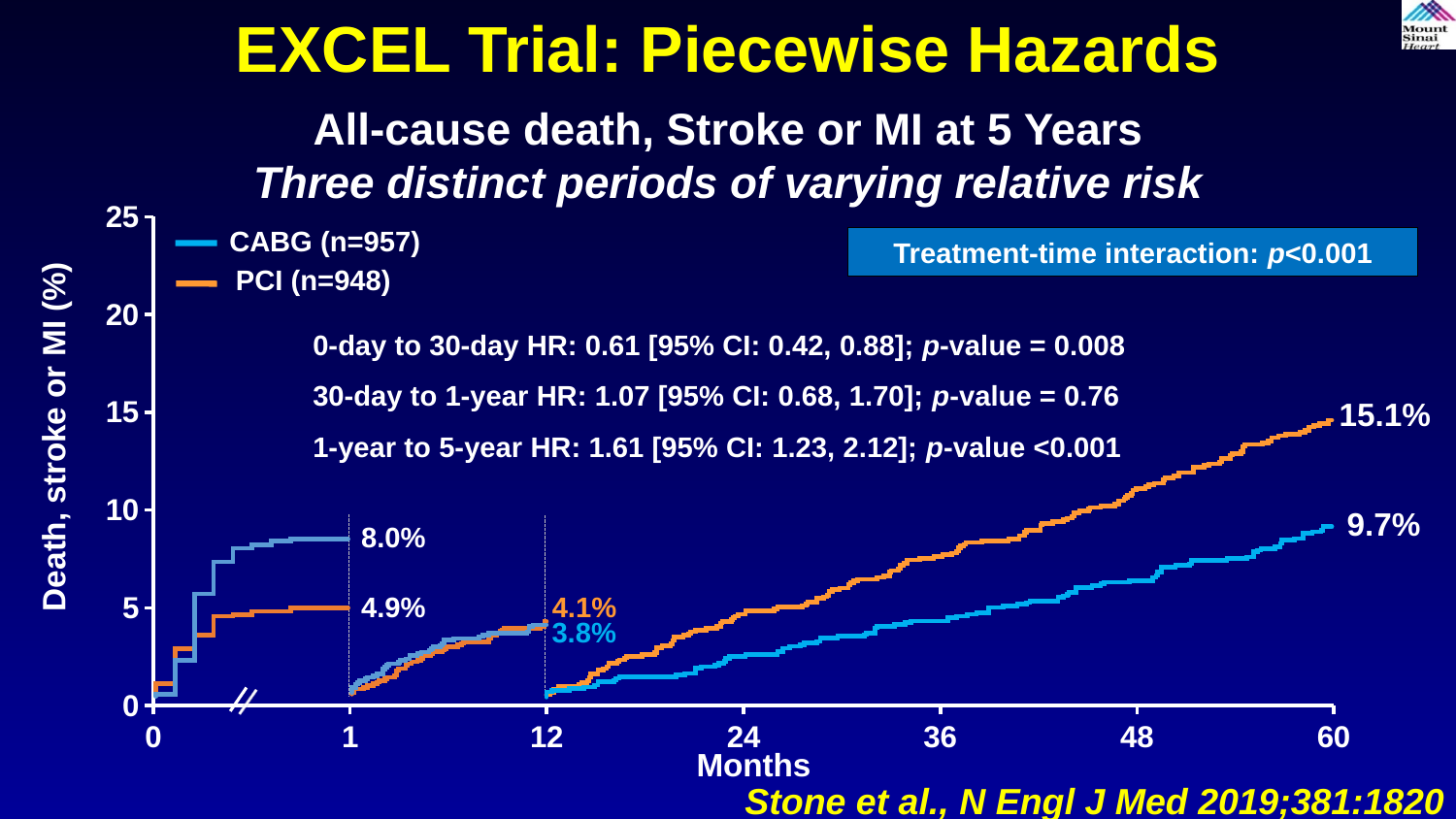
What is the label of the y axis? Death, stroke or MI (%) Which series has the higher value at 1 month, CABG or PCI? CABG What is the value for PCI at 1 month? 4.9% What is the value for CABG at 1 month? 8.0% What is the difference between the PCI and CABG values at 60 months? 5.4% How many series does the legend list? 2 What is the value for PCI at 60 months? 15.1% What is the value for CABG at 60 months? 9.7% Which series has the higher value at 60 months, CABG or PCI? PCI What kind of chart is shown on the slide? Line chart What is the difference between the CABG and PCI values at 1 month? 3.1% Is the value for PCI at 60 months greater or less than 15? greater